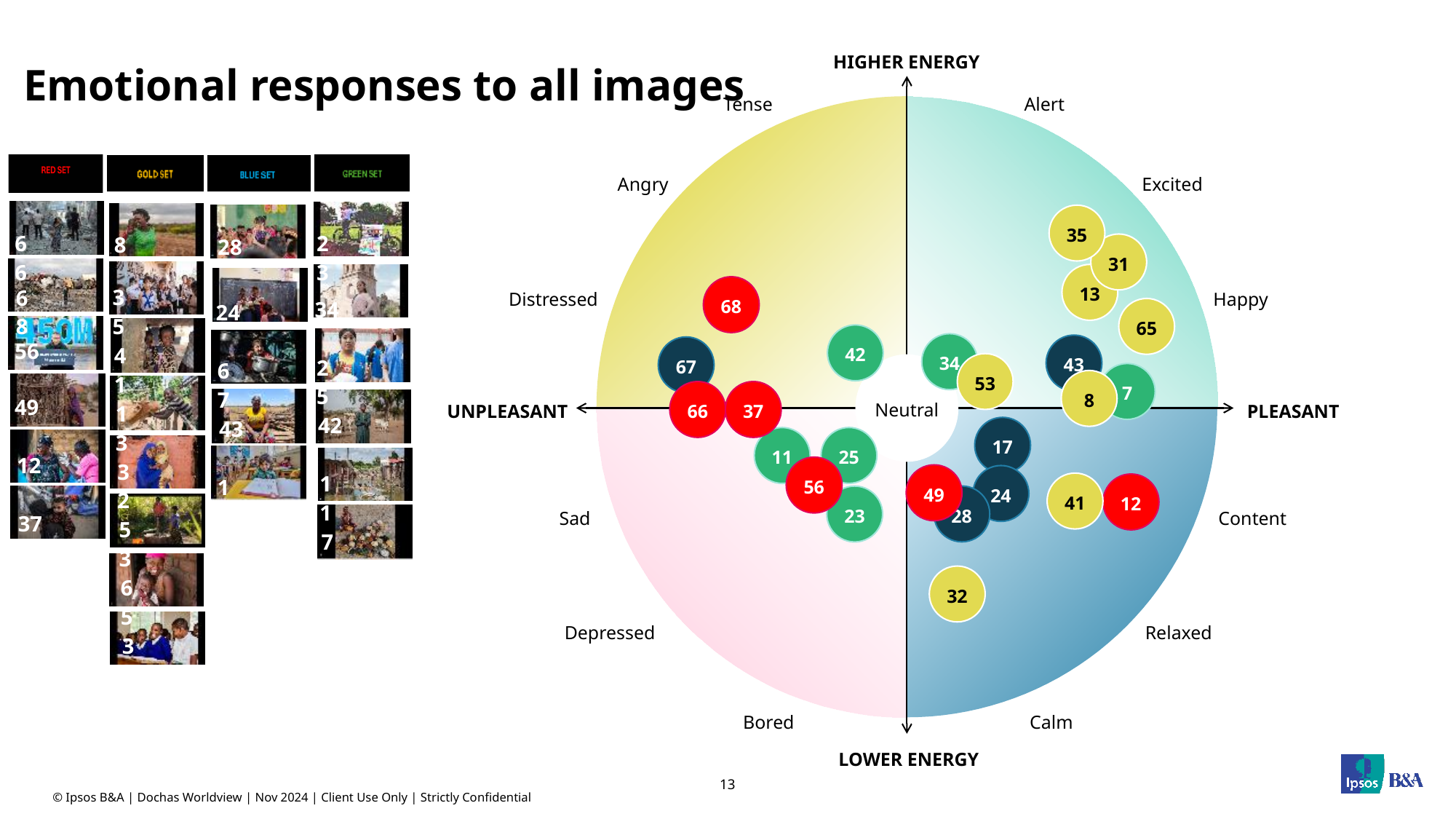
How many red bubbles are plotted on the chart? 6 What label appears at the top end of the vertical axis of the chart? HIGHER ENERGY Which numbered bubble is plotted highest on the energy axis? 35 What is the title of the chart on the slide? Emotional responses to all images What kind of chart is shown on the slide? Scatter chart Is bubble 42 on the unpleasant side or the pleasant side of the chart? Unpleasant In which quadrant of the chart is bubble 41 located? Lower right (pleasant, lower energy) How many green bubbles are plotted on the chart? 6 In which quadrant of the chart is bubble 68 located? Upper left (unpleasant, higher energy) Which numbered bubble is plotted lowest on the energy axis? 32 How many dark blue bubbles are plotted on the chart? 5